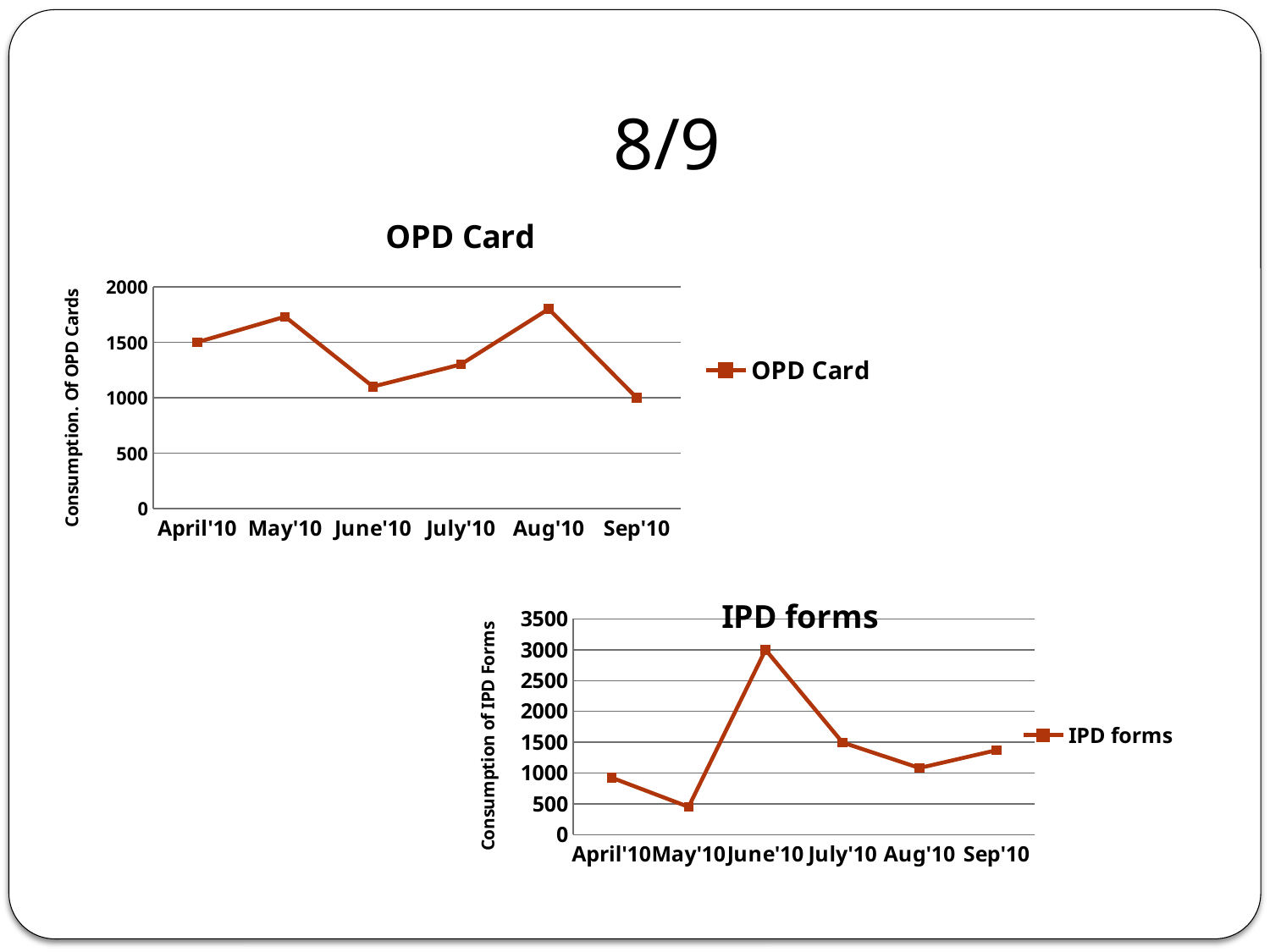
In the IPD forms chart, which is larger, the value for April'10 or the value for Sep'10? Sep'10 In the OPD Card chart, which month has the highest value? Aug'10 In the IPD forms chart, which month has the lowest value? May'10 In the OPD Card chart, is the value for May'10 greater or less than 1500? greater In the IPD forms chart, what is the value for June'10? 3000 How many months are plotted on the IPD forms chart? 6 What kind of chart is the OPD Card chart? line chart What is the y-axis title of the IPD forms chart? Consumption of IPD Forms How many series does the legend of the OPD Card chart list? 1 In the OPD Card chart, what is the value for April'10? 1500 In the OPD Card chart, what is the value for Sep'10? 1000 In the IPD forms chart, is the value for Aug'10 greater or less than 1500? less